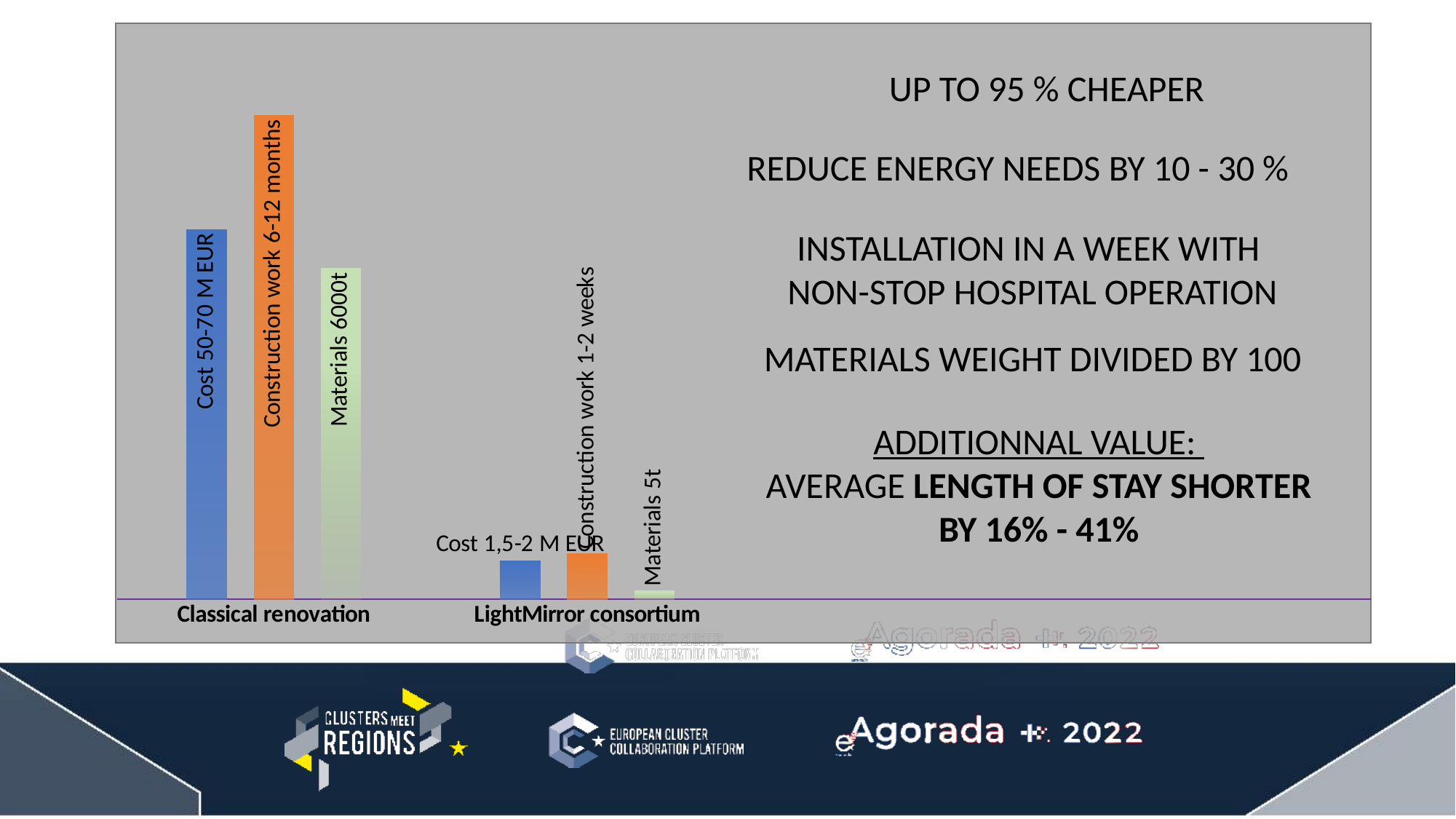
What materials weight is labelled for Classical renovation? Materials 6000t How many categories are shown on the x axis of the chart? 2 What is the cost label shown on the bar for Classical renovation? Cost 50-70 M EUR Which category has the taller materials bar, Classical renovation or LightMirror consortium? Classical renovation What materials weight is labelled for the LightMirror consortium? Materials 5t Which bar is the tallest in the chart? Construction work 6-12 months (Classical renovation) How many bars are plotted for the Classical renovation category? 3 What construction work duration is labelled for Classical renovation? Construction work 6-12 months What is the cost label shown for the LightMirror consortium? Cost 1,5-2 M EUR What kind of chart is shown on the slide? bar chart Which bar is the shortest in the chart? Materials 5t (LightMirror consortium) What construction work duration is labelled for the LightMirror consortium? Construction work 1-2 weeks